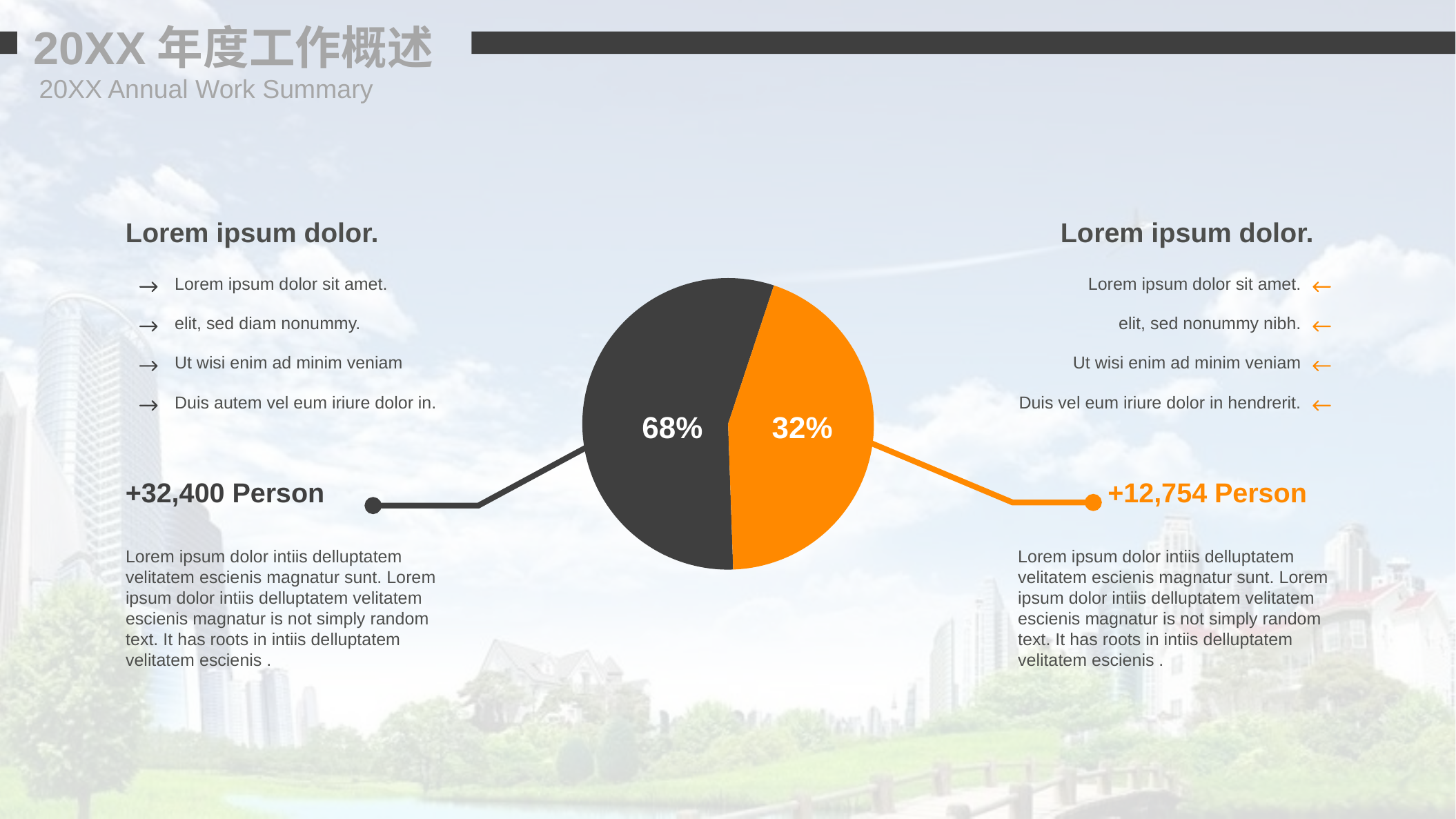
What figure is connected to the orange slice of the pie chart? +12,754 Person What colour is the slice labelled 32%? orange What percentage is shown on the orange slice of the pie chart? 32% What percentage is shown on the dark grey slice of the pie chart? 68% Which slice of the pie chart is the smallest? the orange slice (32%) What figure is connected to the dark grey slice of the pie chart? +32,400 Person What share of the pie does the orange slice represent? 32% What is the difference in percentage points between the dark grey slice and the orange slice? 36 Which is larger, the dark grey slice or the orange slice? the dark grey slice How many slices does the pie chart have? 2 What kind of chart is shown on the slide? pie chart Which slice of the pie chart is the largest? the dark grey slice (68%)